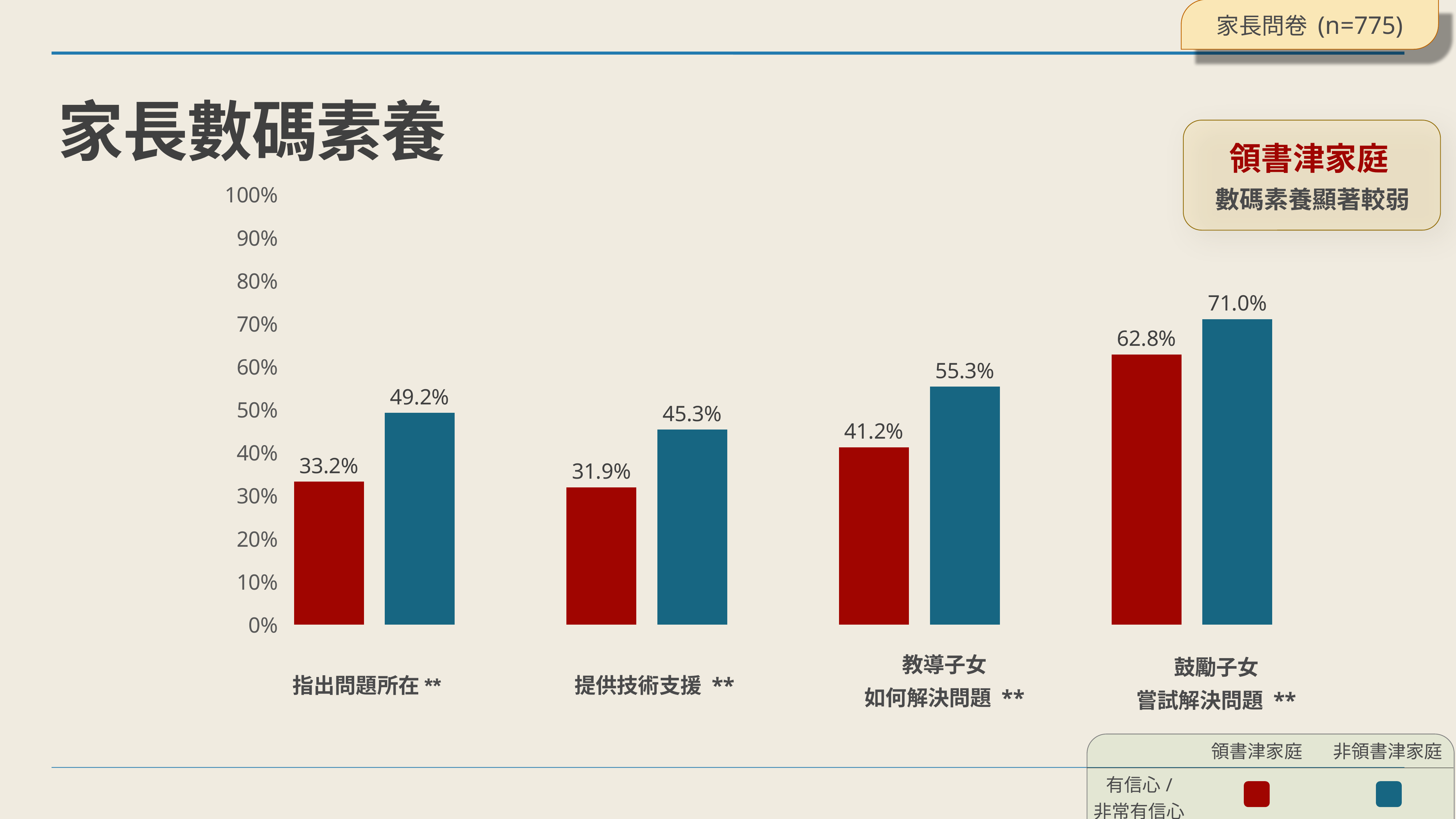
Is the value for 非領書津家庭 in the 指出問題所在 category greater or less than 40%? greater Which colour represents 領書津家庭 in the chart? red How many categories are shown on the x axis of the chart? 4 Which category has the lowest value for 領書津家庭? 提供技術支援 What is the value for 領書津家庭 in the 指出問題所在 category? 33.2% What is the difference between 非領書津家庭 and 領書津家庭 in the 鼓勵子女嘗試解決問題 category? 8.2% In the 教導子女如何解決問題 category, which series has the larger value, 領書津家庭 or 非領書津家庭? 非領書津家庭 What is the value for 非領書津家庭 in the 提供技術支援 category? 45.3% What kind of chart is shown on the slide? bar chart What is the value for 領書津家庭 in the 教導子女如何解決問題 category? 41.2% How many series does the legend list? 2 Which category has the highest value for 非領書津家庭? 鼓勵子女嘗試解決問題